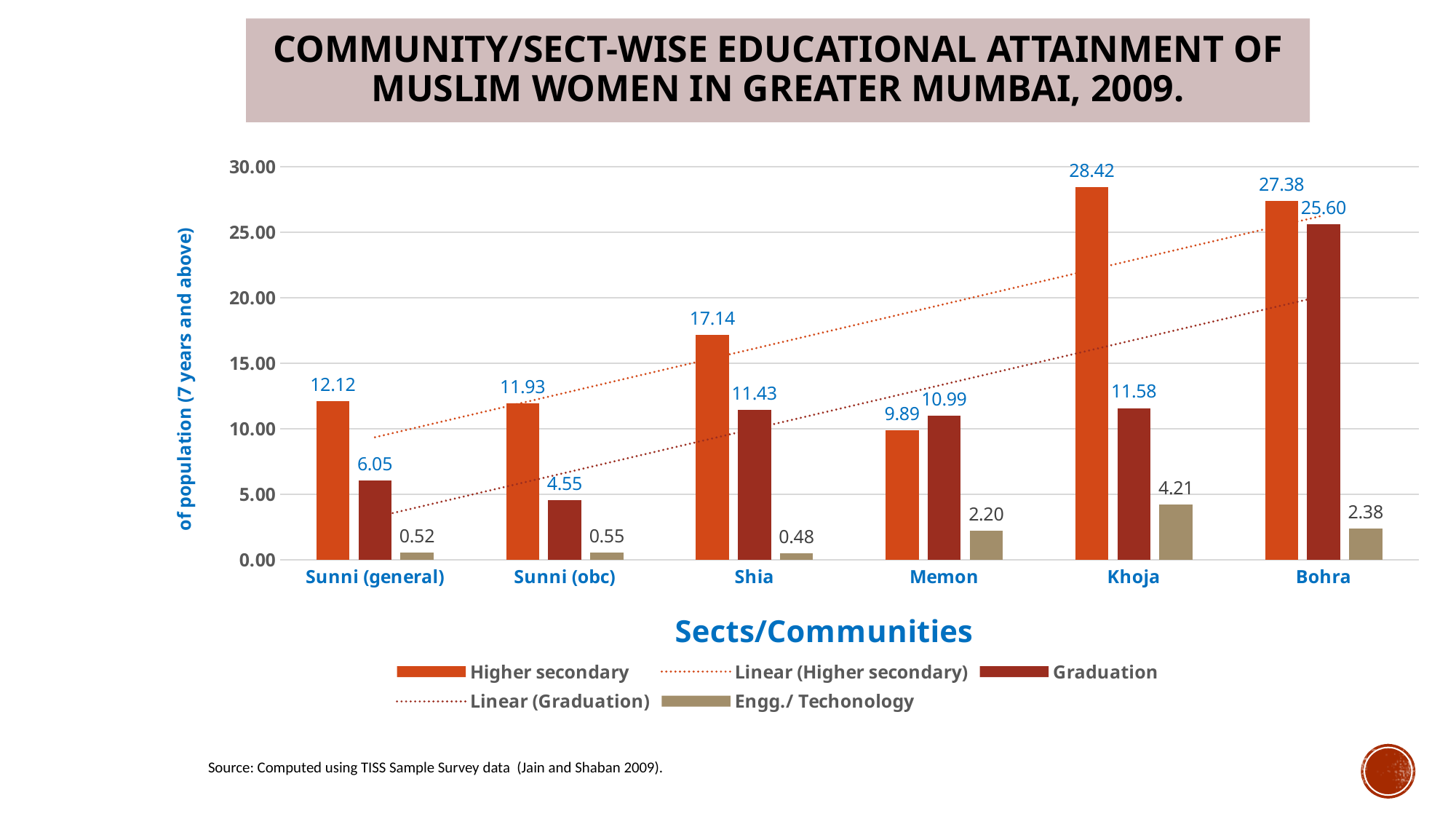
Is the Higher secondary value for Shia greater or less than 15.00? greater How many sects/communities are shown on the x axis? 6 Which community has the lowest Engg./ Techonology value? Shia What is the difference between the Higher secondary and Graduation values for Bohra? 1.78 Which community has the highest Higher secondary value? Khoja What is the Engg./ Techonology value for Bohra? 2.38 Which is larger for Memon: the Higher secondary value or the Graduation value? Graduation How many entries does the legend list? 5 What kind of chart is shown on the slide? Bar chart What is the label of the x axis? Sects/Communities What is the Graduation value for Memon? 10.99 What is the Higher secondary value for Khoja? 28.42